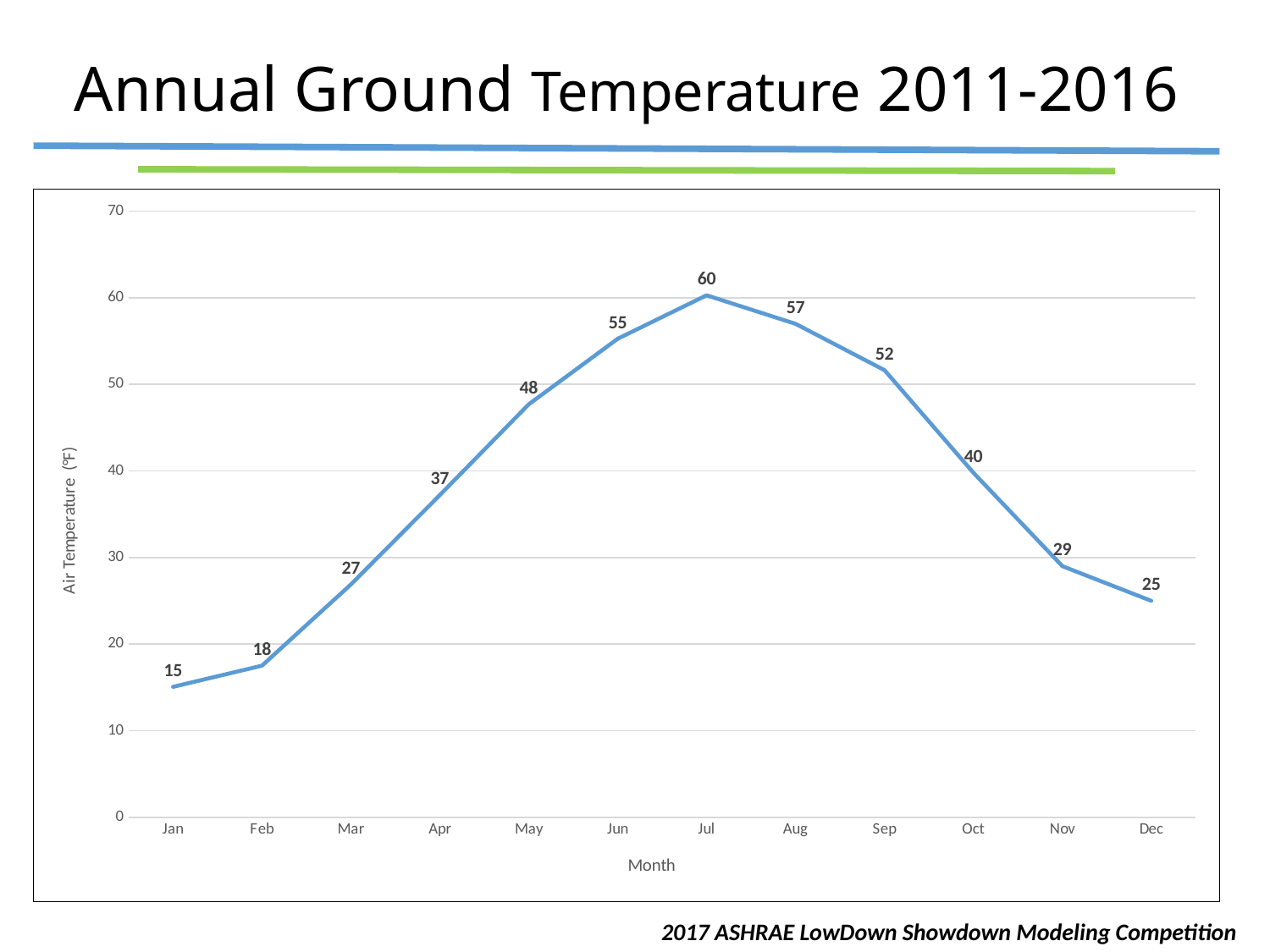
Do the values rise or fall from Jan to Jul? Rise What is the difference between the air temperature in Aug and in Sep? 5 What is the air temperature value for Jul? 60 What is the difference between the air temperature in Jul and in Jan? 45 Which month has the lowest air temperature? Jan How many months are plotted on the chart? 12 What is the air temperature value for Oct? 40 What is the label of the y axis? Air Temperature (°F) Which month has the highest air temperature? Jul Which month has a higher air temperature, Apr or Nov? Apr What is the air temperature value for Jan? 15 What kind of chart is shown on the slide? Line chart